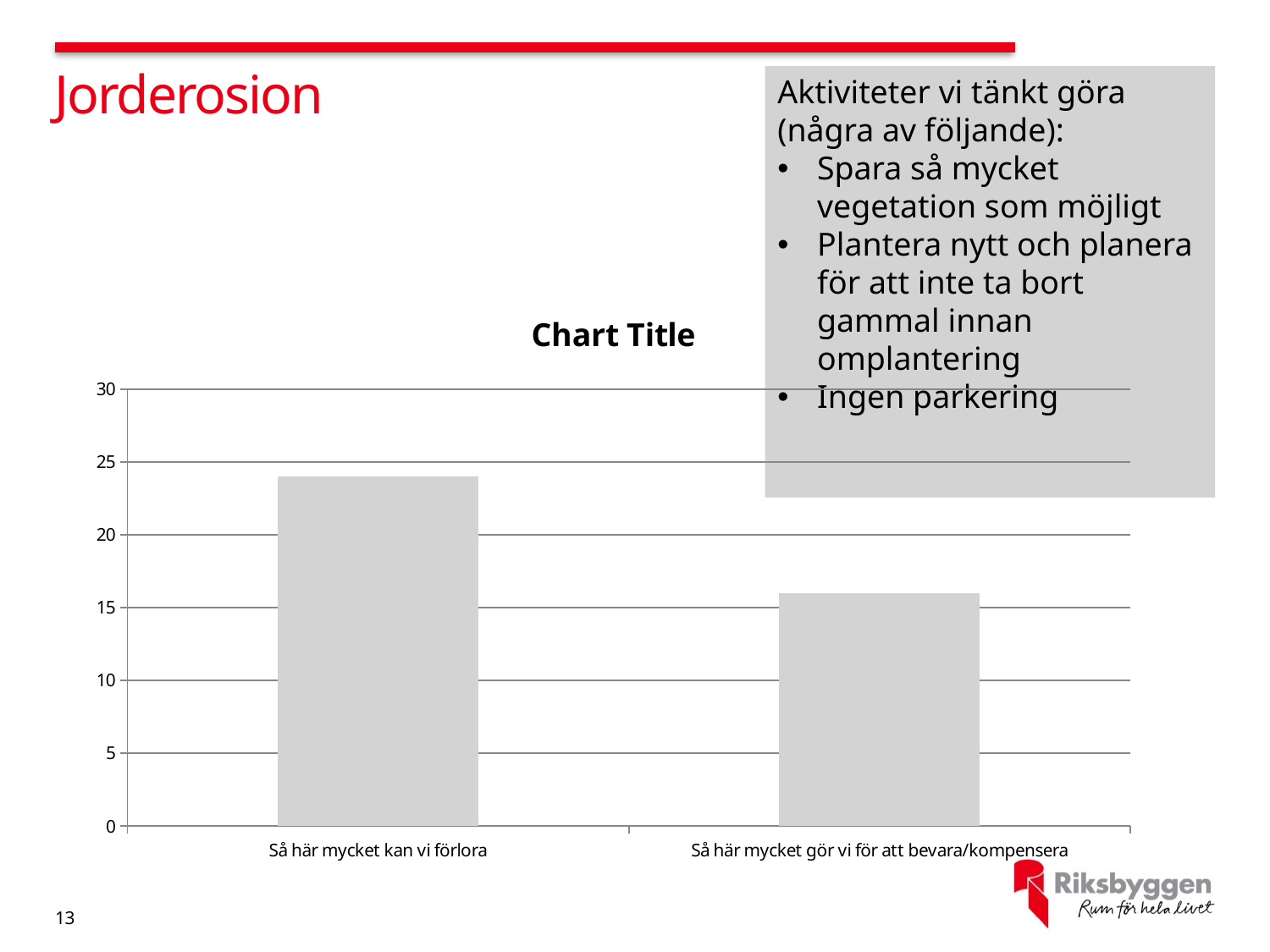
Is the value for 'Så här mycket gör vi för att bevara/kompensera' greater or less than 20? less What is the title of the chart? Chart Title Which category has the highest bar in the chart? Så här mycket kan vi förlora What kind of chart is shown on the slide? bar chart Which category has the lowest bar in the chart? Så här mycket gör vi för att bevara/kompensera Is the value for 'Så här mycket kan vi förlora' greater or less than 20? greater What is the highest value shown on the vertical axis of the chart? 30 How many categories are plotted in the chart? 2 Is the value for 'Så här mycket kan vi förlora' greater or less than 25? less Which is larger: the value for 'Så här mycket kan vi förlora' or the value for 'Så här mycket gör vi för att bevara/kompensera'? Så här mycket kan vi förlora Do the bar values rise or fall from left to right along the x axis? fall